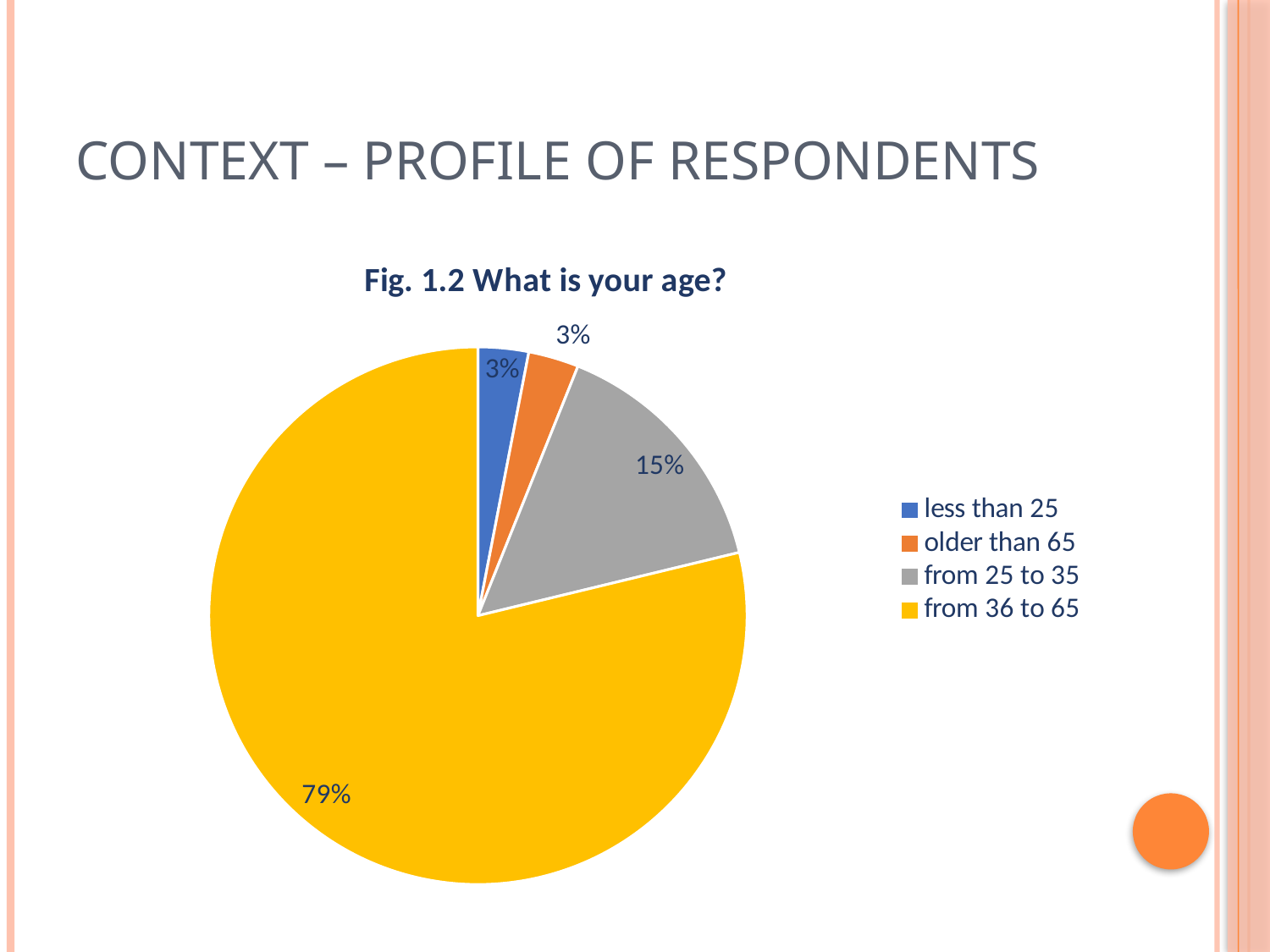
What kind of chart is shown on the slide? pie chart What is the difference between the share for from 36 to 65 and the share for from 25 to 35? 64% Which is larger, the share for from 25 to 35 or the share for older than 65? from 25 to 35 What share of respondents are older than 65? 3% Which age group has the largest share of respondents? from 36 to 65 What share of respondents are from 25 to 35? 15% What is the title of the chart? Fig. 1.2 What is your age? How many categories does the legend list? 4 What share of respondents are less than 25? 3% What colour is the slice for from 36 to 65? yellow What share of respondents are from 36 to 65? 79% What is the combined share of respondents less than 25 and older than 65? 6%